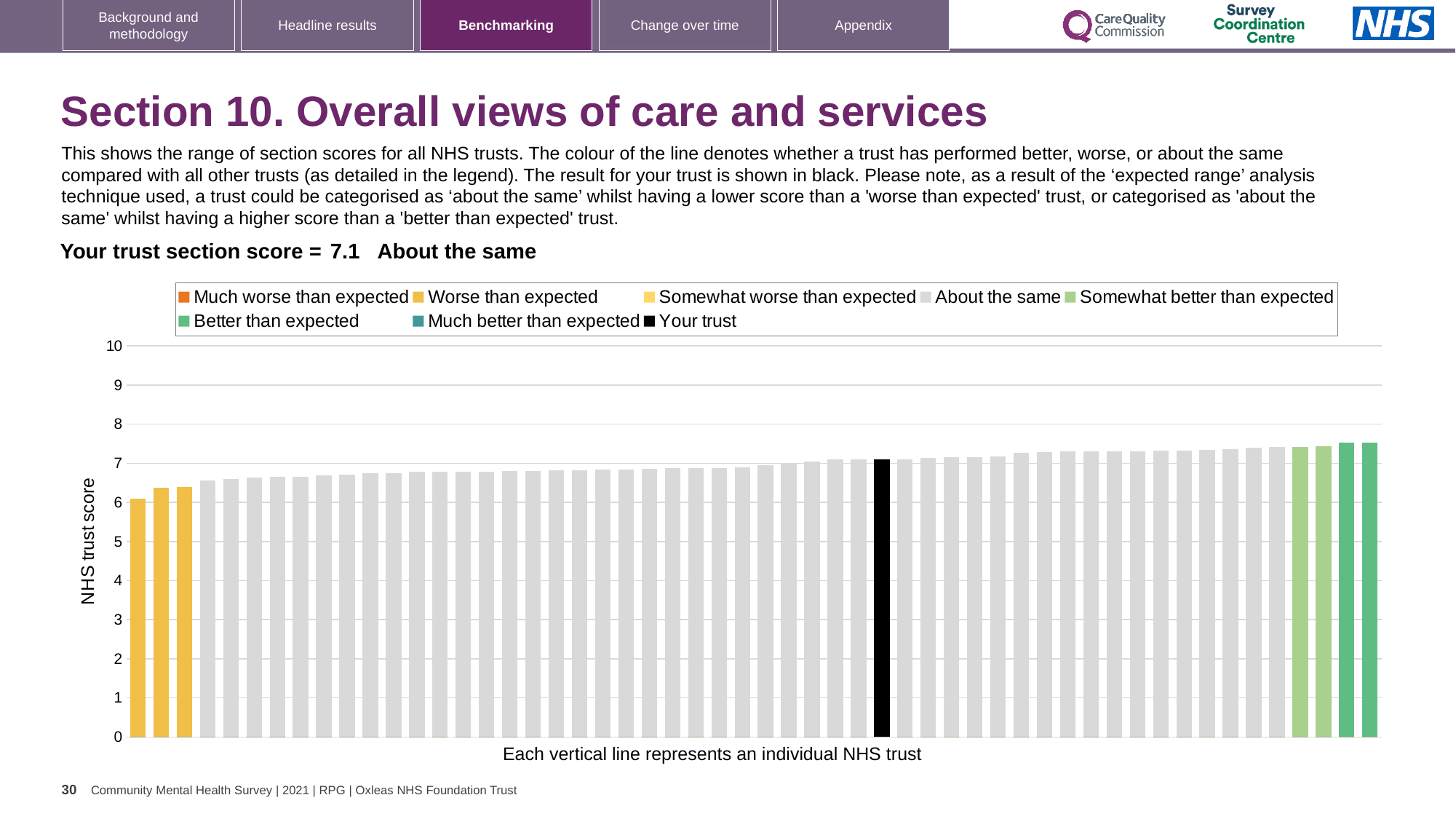
Which category is your trust placed in for this section? About the same What kind of chart is shown on the slide? bar chart What is the label on the vertical axis of the chart? NHS trust score Is the value for your trust (the black bar) greater or less than 6? greater Do the bar values rise or fall from left to right along the x axis? rise How many bars are coloured as 'Worse than expected'? 3 How many bars are coloured as 'Much better than expected'? 0 What is the section score for your trust? 7.1 Is the value of the highest bar in the chart greater or less than 8? less What colour is the bar representing your trust? black Is the value of the lowest bar in the chart greater or less than 5? greater How many entries does the chart legend list? 8